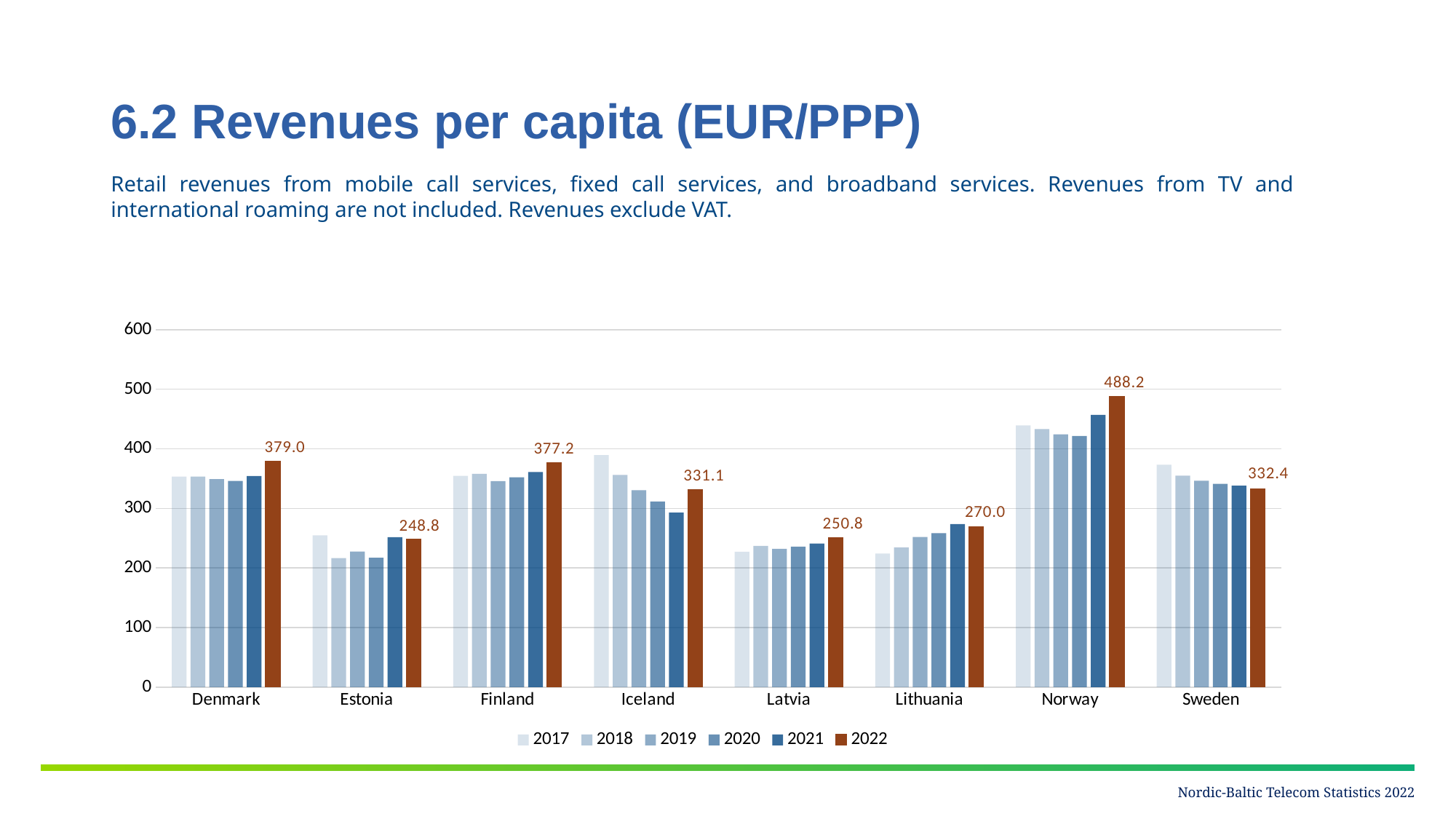
What is the 2022 revenue per capita for Norway? 488.2 What kind of chart is shown on the slide? Bar chart Which country has the lowest revenue per capita in 2022? Estonia Which country has the highest revenue per capita in 2022? Norway What is the difference between the 2022 values for Norway and Denmark? 109.2 What is the 2022 value shown for Lithuania? 270.0 Is the 2017 value for Norway greater or less than 400? greater What is the difference between the 2022 values for Lithuania and Latvia? 19.2 Which has the larger 2022 value, Denmark or Finland? Denmark What is the 2022 revenue per capita for Estonia? 248.8 How many countries are shown on the x axis? 8 How many series (years) does the legend list? 6